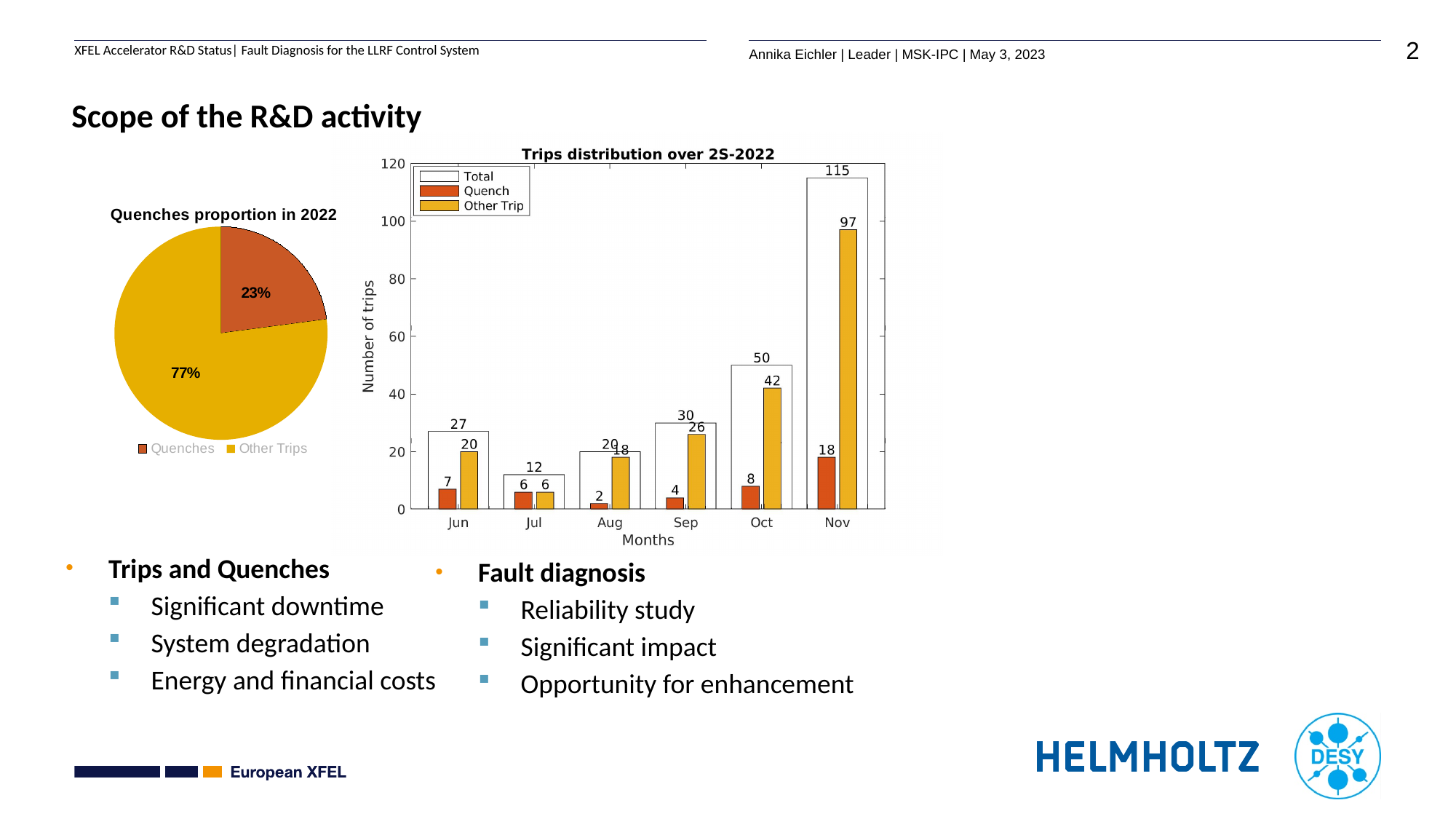
In the 'Trips distribution over 2S-2022' chart, what is the Total value for Nov? 115 In the 'Trips distribution over 2S-2022' chart, is the Quench value for Nov larger or smaller than the Quench value for Jun? larger In the 'Quenches proportion in 2022' pie chart, which slice is larger, Quenches or Other Trips? Other Trips In the 'Trips distribution over 2S-2022' chart, what is the Other Trip value for Sep? 26 In the 'Quenches proportion in 2022' pie chart, what share do Quenches have? 23% In the 'Trips distribution over 2S-2022' chart, how many months are shown on the x axis? 6 What kind of chart is 'Quenches proportion in 2022'? pie chart In the 'Trips distribution over 2S-2022' chart, which month has the lowest Quench value? Aug In the 'Trips distribution over 2S-2022' chart, how many series does the legend list? 3 In the 'Trips distribution over 2S-2022' chart, what is the Quench value for Oct? 8 In the 'Trips distribution over 2S-2022' chart, which month has the highest Total? Nov In the 'Trips distribution over 2S-2022' chart, what is the difference between the Other Trip values for Nov and Oct? 55